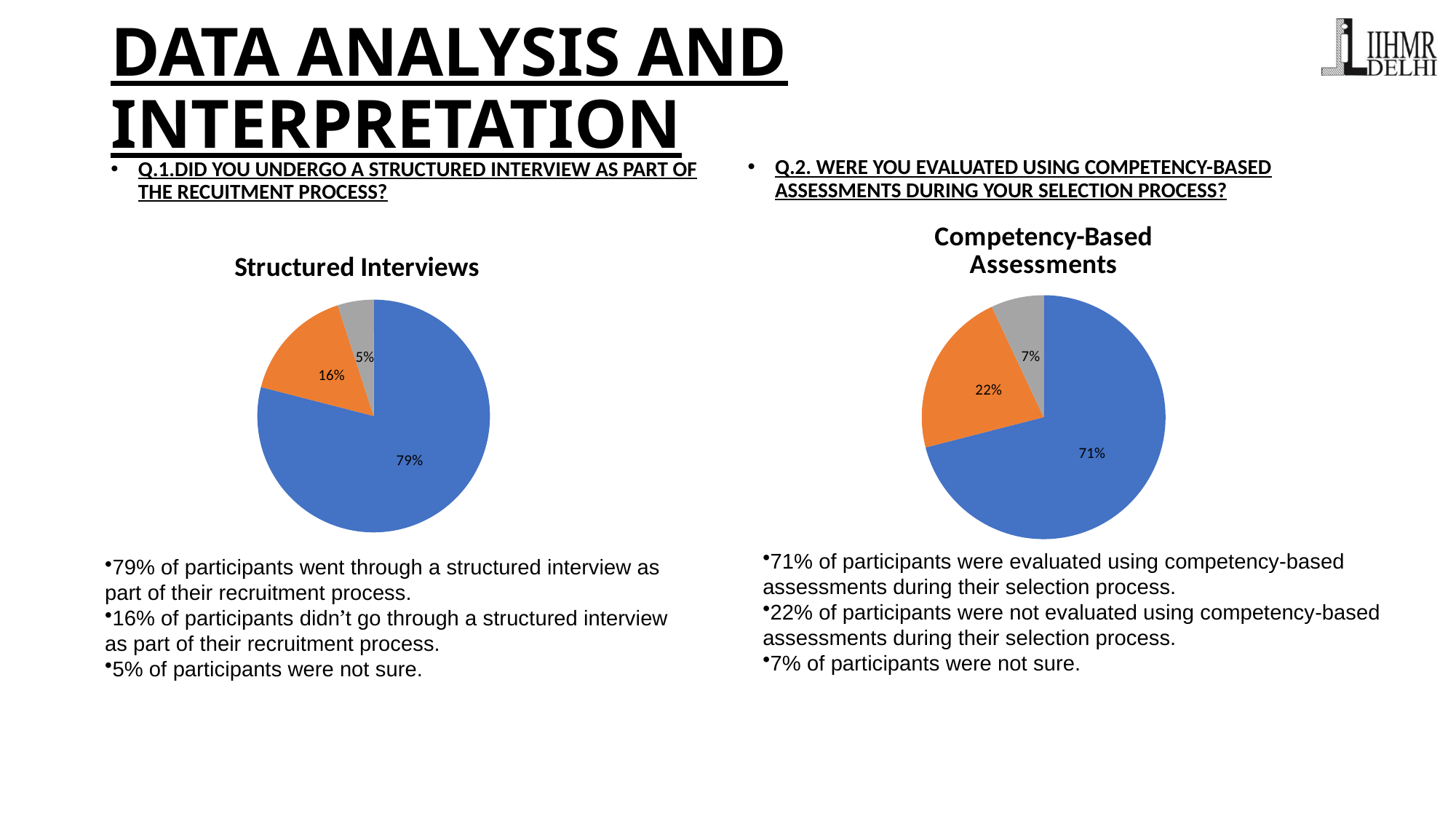
In the "Structured Interviews" chart, what is the difference between the largest slice and the orange slice? 63% In the "Competency-Based Assessments" chart, what percentage is shown on the blue slice? 71% In the "Competency-Based Assessments" chart, what percentage is shown on the orange slice? 22% In the "Structured Interviews" chart, what percentage is shown on the orange slice? 16% In the "Structured Interviews" chart, what percentage is shown on the smallest slice? 5% What type of chart is the "Structured Interviews" chart? pie chart In the "Competency-Based Assessments" chart, what percentage is shown on the grey slice? 7% In the "Structured Interviews" chart, what percentage is shown on the largest slice? 79% How many slices does the "Competency-Based Assessments" pie chart have? 3 What is the title of the pie chart on the left side of the slide? Structured Interviews How many slices does the "Structured Interviews" pie chart have? 3 Which is larger: the orange slice in the "Structured Interviews" chart or the orange slice in the "Competency-Based Assessments" chart? Competency-Based Assessments